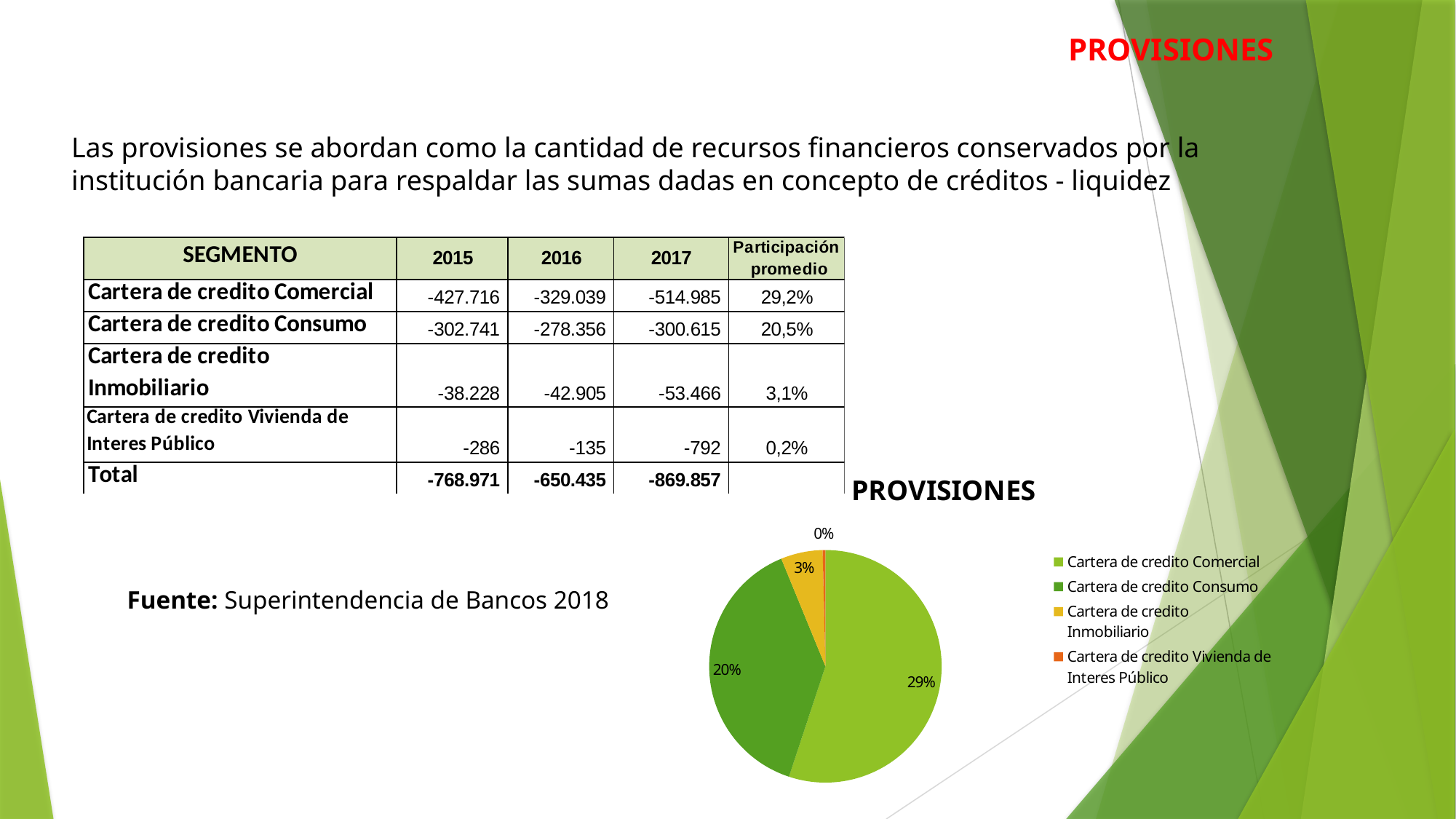
What type of chart is shown on the slide? pie chart Which slice is larger in the pie chart, Cartera de credito Consumo or Cartera de credito Inmobiliario? Cartera de credito Consumo Which segment has the smallest slice in the pie chart? Cartera de credito Vivienda de Interes Público What percentage is shown for Cartera de credito Inmobiliario in the pie chart? 3% How many slices does the pie chart have? 4 How many entries does the chart legend list? 4 What is the difference in percentage points between the Cartera de credito Comercial slice and the Cartera de credito Consumo slice? 9 What percentage is shown for Cartera de credito Vivienda de Interes Público in the pie chart? 0% Which segment has the largest slice in the pie chart? Cartera de credito Comercial What percentage is shown for Cartera de credito Consumo in the pie chart? 20% What is the title of the chart? PROVISIONES What percentage is shown for Cartera de credito Comercial in the pie chart? 29%